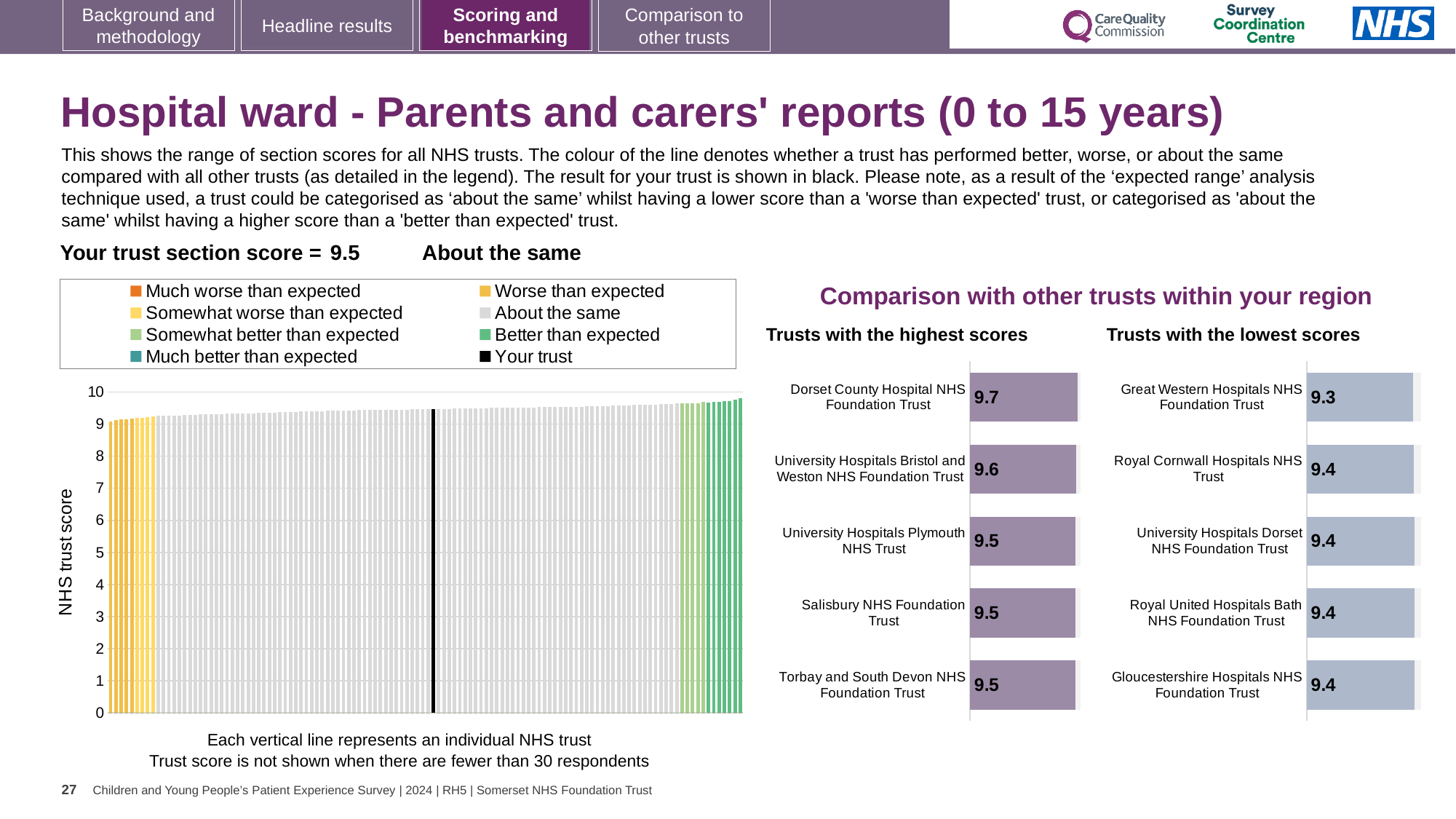
In the 'Trusts with the lowest scores' chart, what is the score for Great Western Hospitals NHS Foundation Trust? 9.3 What type of chart is the large chart on the left showing NHS trust scores? Bar chart In the 'Trusts with the lowest scores' chart, what is the difference between the scores of Gloucestershire Hospitals NHS Foundation Trust and Great Western Hospitals NHS Foundation Trust? 0.1 In the 'Trusts with the lowest scores' chart, what is the score for Royal Cornwall Hospitals NHS Trust? 9.4 How many entries does the legend of the left-hand chart list? 8 Which is larger: the score for Dorset County Hospital NHS Foundation Trust in the highest scores chart or the score for Great Western Hospitals NHS Foundation Trust in the lowest scores chart? Dorset County Hospital NHS Foundation Trust In the 'Trusts with the lowest scores' chart, which trust has the lowest score? Great Western Hospitals NHS Foundation Trust In the 'Trusts with the highest scores' chart, which trust has the highest score? Dorset County Hospital NHS Foundation Trust In the 'Trusts with the highest scores' chart, what is the score for Dorset County Hospital NHS Foundation Trust? 9.7 In the 'Trusts with the highest scores' chart, what is the score for University Hospitals Bristol and Weston NHS Foundation Trust? 9.6 How many trusts are listed in the 'Trusts with the highest scores' chart? 5 In the 'Trusts with the highest scores' chart, what is the difference between the scores of Dorset County Hospital NHS Foundation Trust and Salisbury NHS Foundation Trust? 0.2